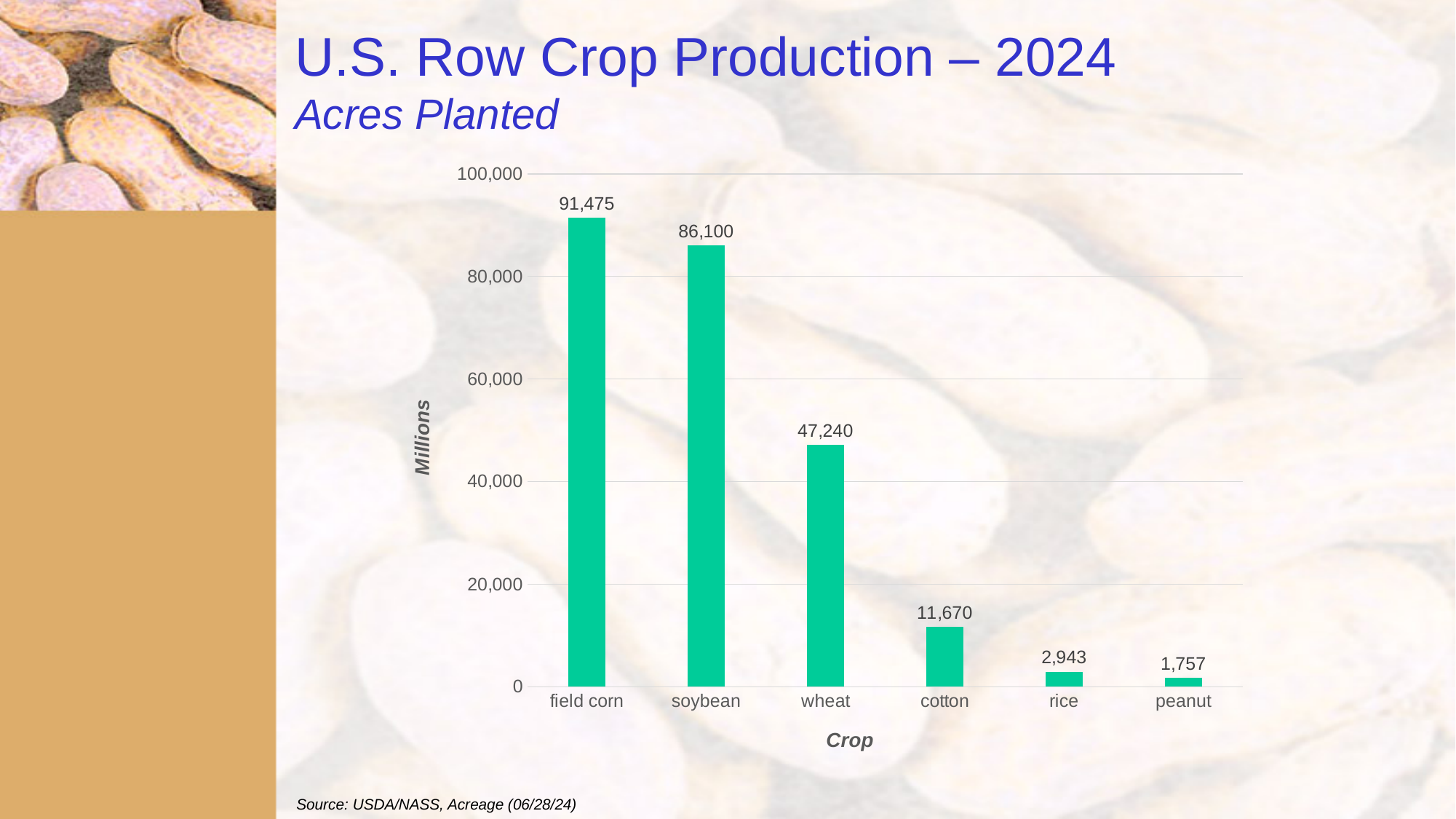
What is the difference between the values for field corn and soybean? 5,375 What is the value for peanut? 1,757 What is the value for field corn? 91,475 What is the label on the y axis of the chart? Millions Which crop has the highest value? field corn Which crop has the lowest value? peanut What kind of chart is shown on the slide? bar chart What is the value for wheat? 47,240 Which is larger, the value for wheat or the value for cotton? wheat Is the value for soybean greater or less than 80,000? greater What is the difference between the values for cotton and rice? 8,727 How many crops are shown on the chart? 6